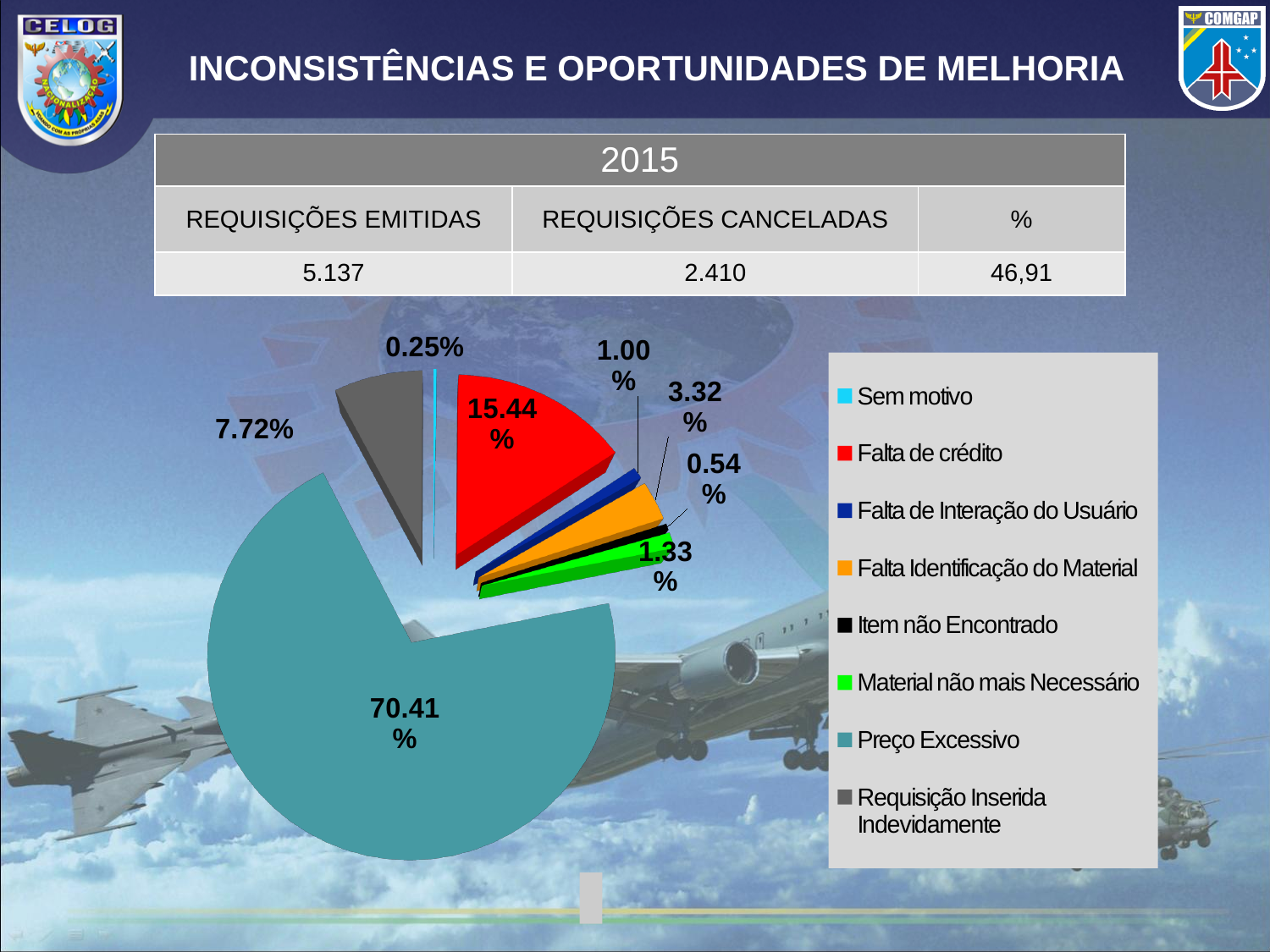
Which is larger, the slice for Falta de crédito or the slice for Requisição Inserida Indevidamente? Falta de crédito What share of the pie does Sem motivo have? 0.25% What share of the pie does Requisição Inserida Indevidamente have? 7.72% What colour is the slice for Preço Excessivo? teal What kind of chart is shown on the slide? pie chart What is the difference between the shares of Preço Excessivo and Falta de crédito? 54.97% Which category has the smallest slice of the pie? Sem motivo Which category has the largest slice of the pie? Preço Excessivo How many entries does the legend list? 8 What share of the pie does Preço Excessivo have? 70.41% What share of the pie does Falta de crédito have? 15.44% How many slices does the pie chart have? 8